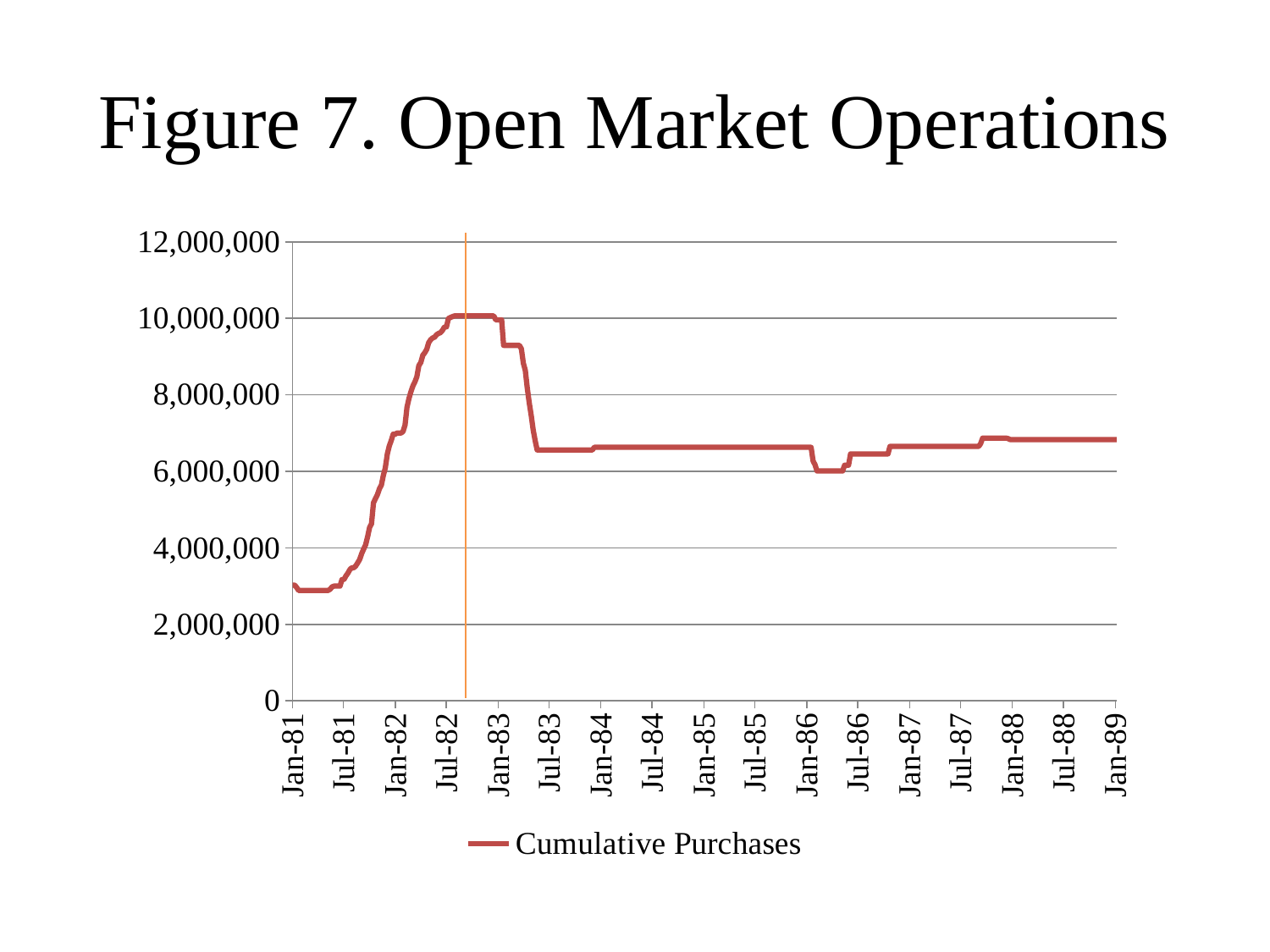
How many date labels are shown on the x axis? 17 How many series does the legend list? 1 What is the title of the slide containing the chart? Figure 7. Open Market Operations Is the value for Cumulative Purchases at Jan-81 greater or less than 4,000,000? less Which is larger, the value for Cumulative Purchases at Jul-82 or at Jan-85? Jul-82 Is the value for Cumulative Purchases at Jan-84 greater or less than 6,000,000? greater Does the Cumulative Purchases line rise or fall between Jan-83 and Jul-83? fall What is the name of the series shown in the legend? Cumulative Purchases Does the Cumulative Purchases line rise or fall between Jan-81 and Jul-82? rise Is the highest value reached by the Cumulative Purchases line greater or less than 8,000,000? greater What kind of chart is shown on the slide? line chart